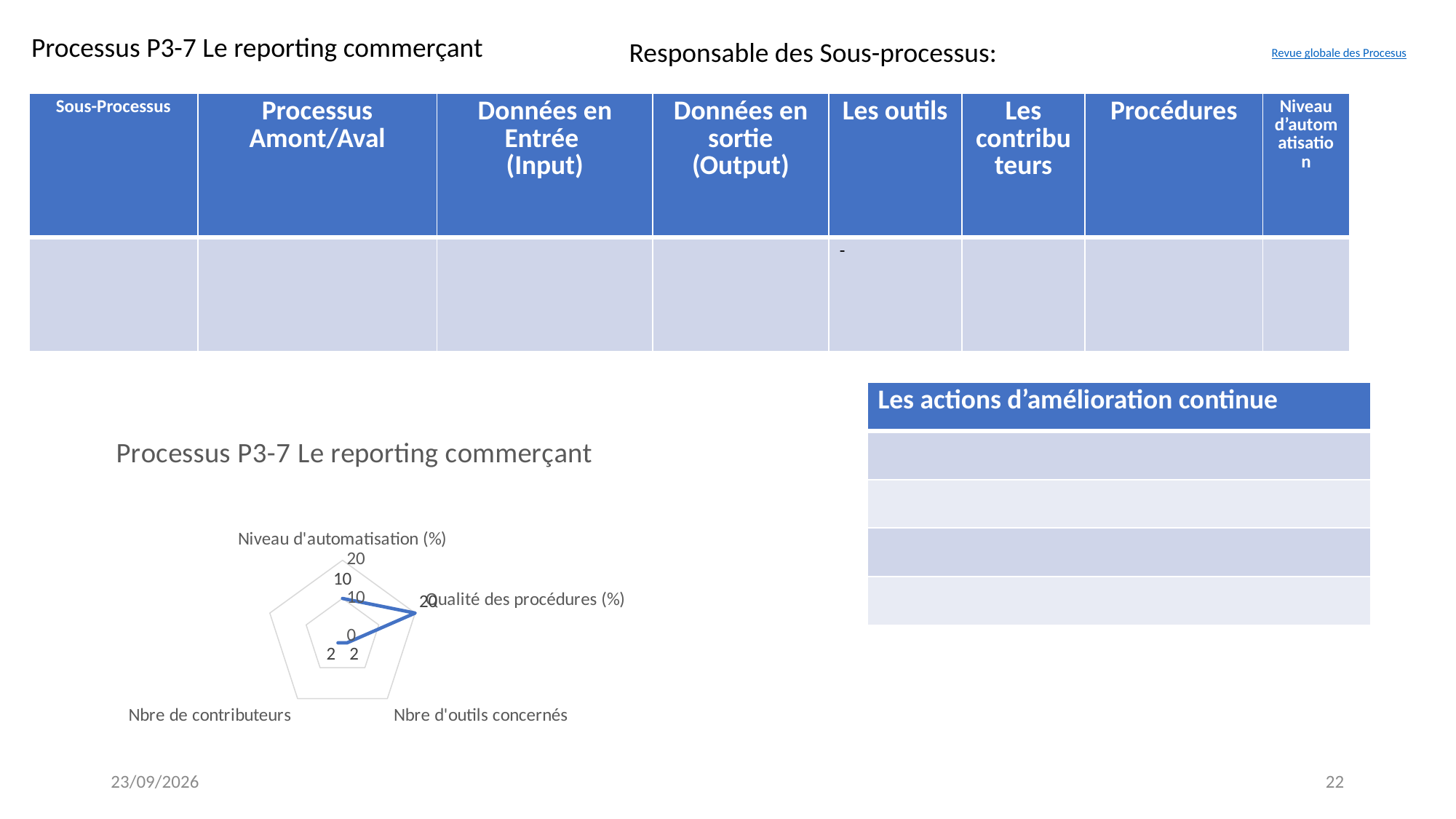
What is the highest tick value shown on the chart's axis scale? 20 What type of chart is shown on the slide? Radar chart What is the value for Niveau d'automatisation (%) in the chart? 10 Which is larger, the value for Qualité des procédures (%) or the value for Niveau d'automatisation (%)? Qualité des procédures (%) Which category has the highest value in the chart? Qualité des procédures (%) How many axes does the radar chart have? 5 What is the value for Nbre de contributeurs in the chart? 2 What is the value for Nbre d'outils concernés in the chart? 2 What is the title of the chart? Processus P3-7 Le reporting commerçant What is the difference between the values for Qualité des procédures (%) and Niveau d'automatisation (%)? 10 Is the value for Qualité des procédures (%) greater or less than 10? greater What is the value for Qualité des procédures (%) in the chart? 20